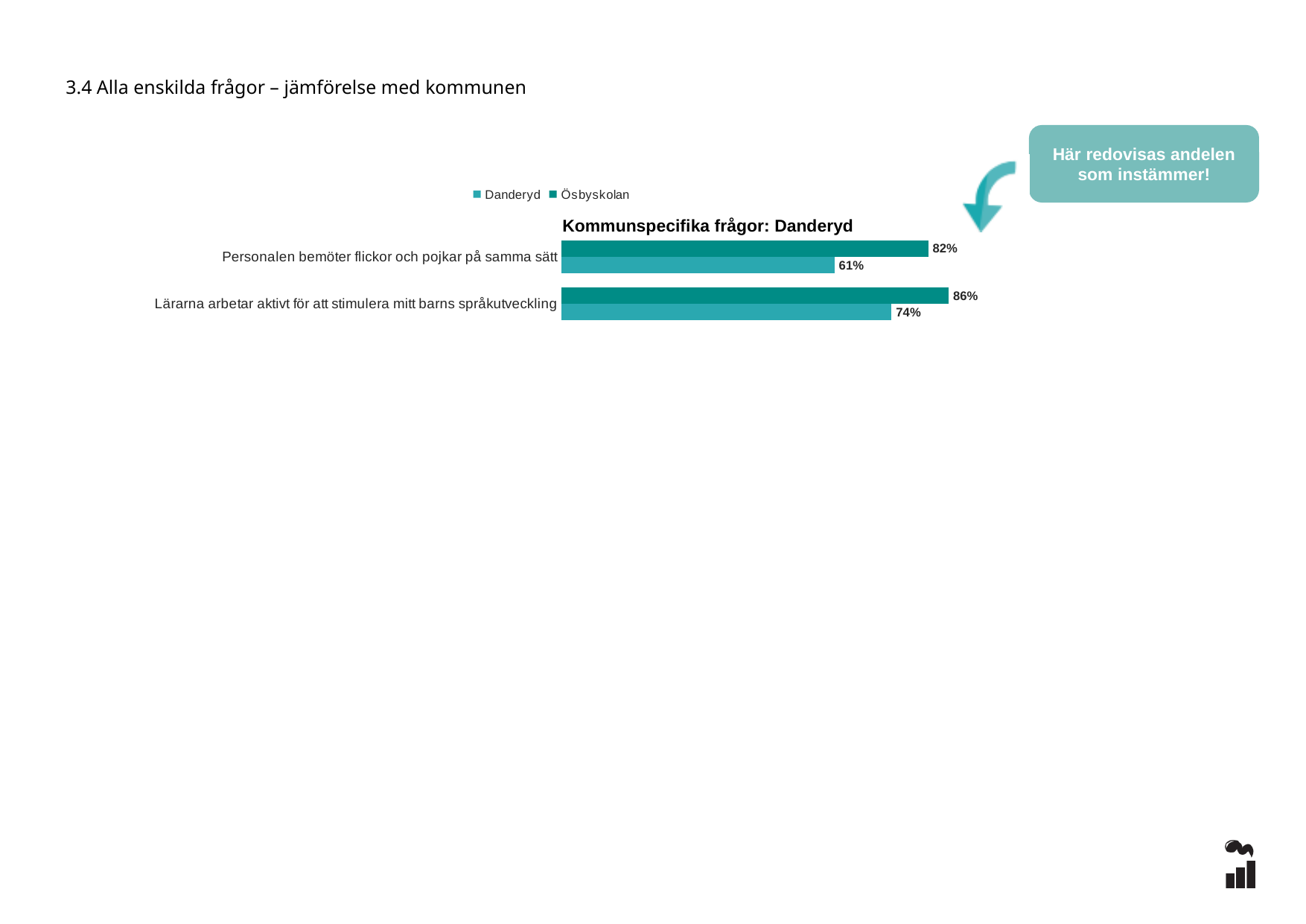
What is the value for Danderyd for 'Personalen bemöter flickor och pojkar på samma sätt'? 61% What is the difference between Ösbyskolan and Danderyd for 'Lärarna arbetar aktivt för att stimulera mitt barns språkutveckling'? 12 percentage points How many categories (questions) are plotted in the chart? 2 What is the title of the chart? Kommunspecifika frågor: Danderyd What is the value for Danderyd for 'Lärarna arbetar aktivt för att stimulera mitt barns språkutveckling'? 74% Which bar has the highest value in the chart? Ösbyskolan, 'Lärarna arbetar aktivt för att stimulera mitt barns språkutveckling' (86%) What is the difference between Ösbyskolan and Danderyd for 'Personalen bemöter flickor och pojkar på samma sätt'? 21 percentage points What is the value for Ösbyskolan for 'Lärarna arbetar aktivt för att stimulera mitt barns språkutveckling'? 86% What kind of chart is shown on the slide? Bar chart How many series does the legend list? 2 Which is larger for 'Lärarna arbetar aktivt för att stimulera mitt barns språkutveckling': Danderyd or Ösbyskolan? Ösbyskolan What is the value for Ösbyskolan for 'Personalen bemöter flickor och pojkar på samma sätt'? 82%